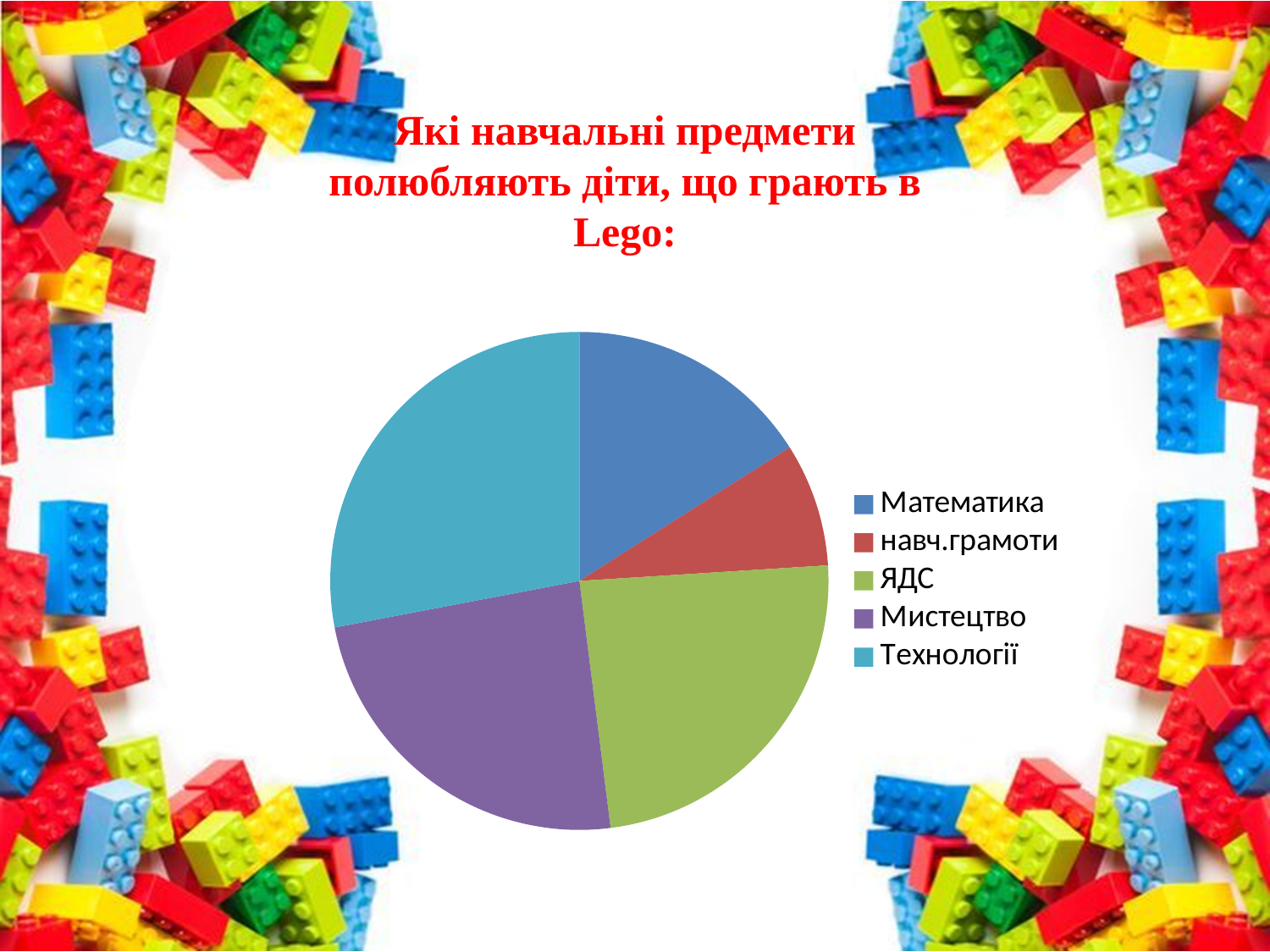
What is the title of the slide above the pie chart? Які навчальні предмети полюбляють діти, що грають в Lego: What colour is the Технології slice in the pie chart? Light blue (teal) Which slice is larger, Математика or навч.грамоти? Математика Which slice is larger, Технології or Математика? Технології Which slice is larger, Мистецтво or Математика? Мистецтво How many entries does the legend of the pie chart list? 5 What kind of chart is shown on the slide? Pie chart How many slices does the pie chart have? 5 Which category has the largest slice in the pie chart? Технології Which category has the smallest slice in the pie chart? навч.грамоти